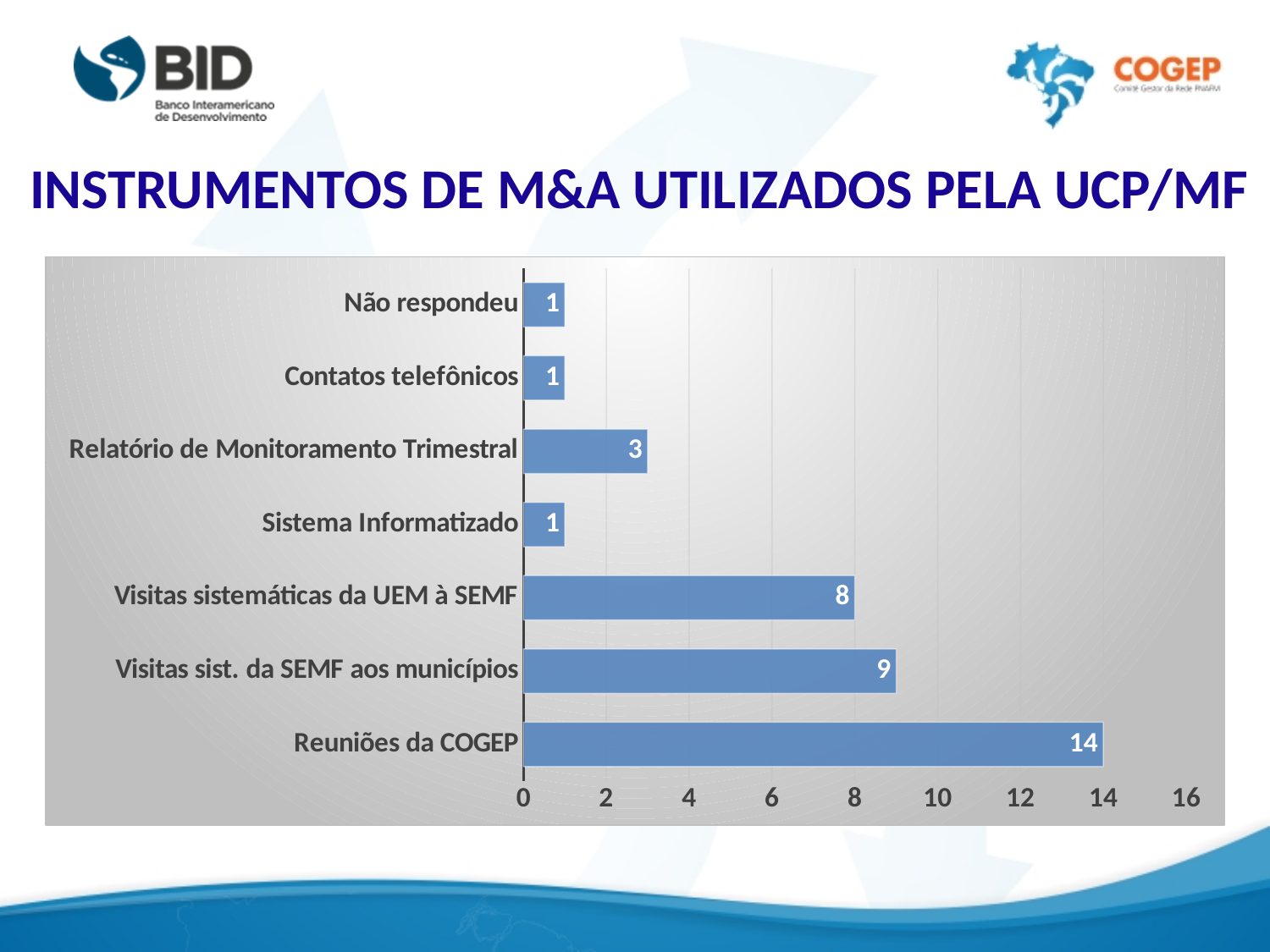
Which is larger, Visitas sistemáticas da UEM à SEMF or Relatório de Monitoramento Trimestral? Visitas sistemáticas da UEM à SEMF Is the value for Reuniões da COGEP greater or less than 10? greater What kind of chart is shown on the slide? bar chart What is the value for Visitas sist. da SEMF aos municípios? 9 What is the value for Relatório de Monitoramento Trimestral? 3 What is the title of the slide above the chart? INSTRUMENTOS DE M&A UTILIZADOS PELA UCP/MF Which category has the highest value? Reuniões da COGEP How many categories have a value of 1? 3 What is the value for Visitas sistemáticas da UEM à SEMF? 8 How many categories are shown in the chart? 7 What is the difference between Reuniões da COGEP and Visitas sist. da SEMF aos municípios? 5 What is the value for Reuniões da COGEP? 14